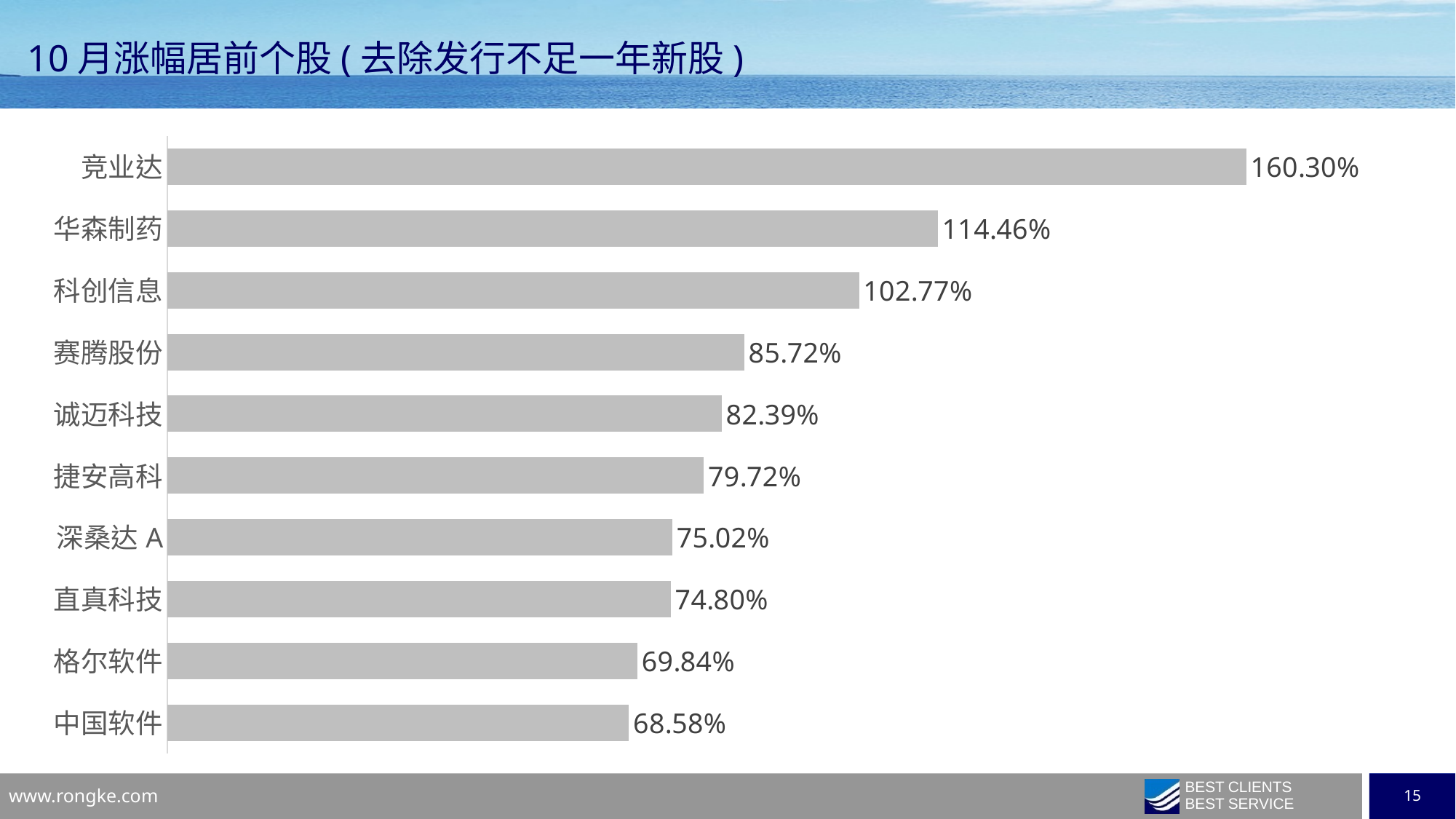
What is the value for 华森制药? 114.46% What kind of chart is shown on the slide? Bar chart Which stock has the highest value on the chart? 竞业达 What is the value for 中国软件? 68.58% Which stock has the lowest value on the chart? 中国软件 What is the difference between the values for 竞业达 and 华森制药? 45.84% What is the difference between the values for 格尔软件 and 中国软件? 1.26% What is the value for 诚迈科技? 82.39% What is the title of the slide? 10月涨幅居前个股（去除发行不足一年新股） Which is larger, the value for 科创信息 or the value for 赛腾股份? 科创信息 What is the value for 竞业达? 160.30% How many stocks are shown on the chart? 10